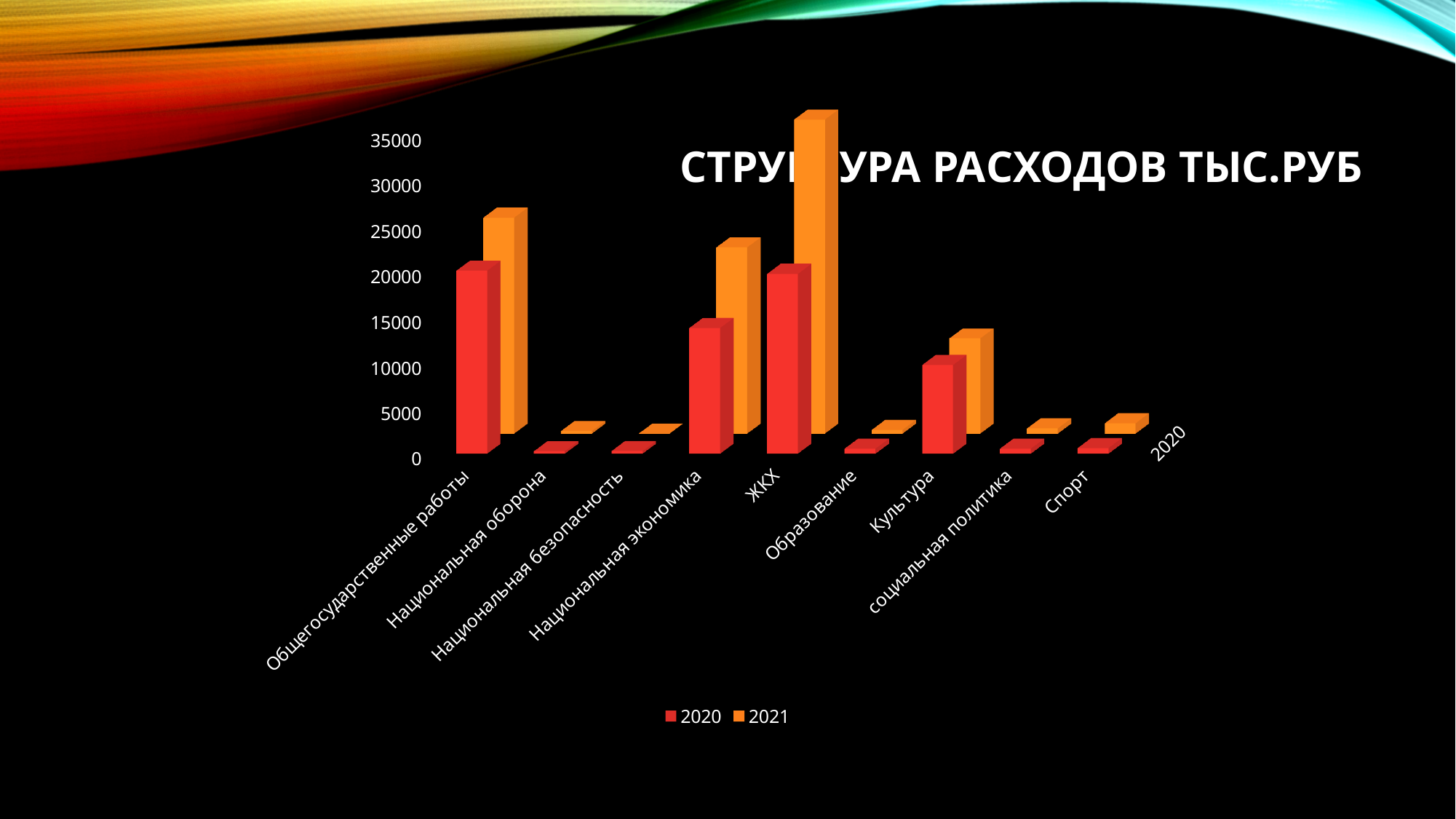
How many categories are shown on the x axis? 9 For the 2021 series, which is larger: ЖКХ or Общегосударственные работы? ЖКХ For Культура, which series has the larger value, 2020 or 2021? 2021 What kind of chart is shown on the slide? bar chart What is the title of the chart? СТРУКТУРА РАСХОДОВ ТЫС.РУБ Is the 2021 value for ЖКХ greater or less than 30000? greater Which colour represents the 2021 series in the legend? orange For the 2020 series, which is larger: Национальная экономика or Культура? Национальная экономика Is the 2020 value for Национальная оборона greater or less than 5000? less Which category has the highest value for the 2021 series? ЖКХ How many series does the legend list? 2 Is the 2020 value for Национальная экономика greater or less than 10000? greater